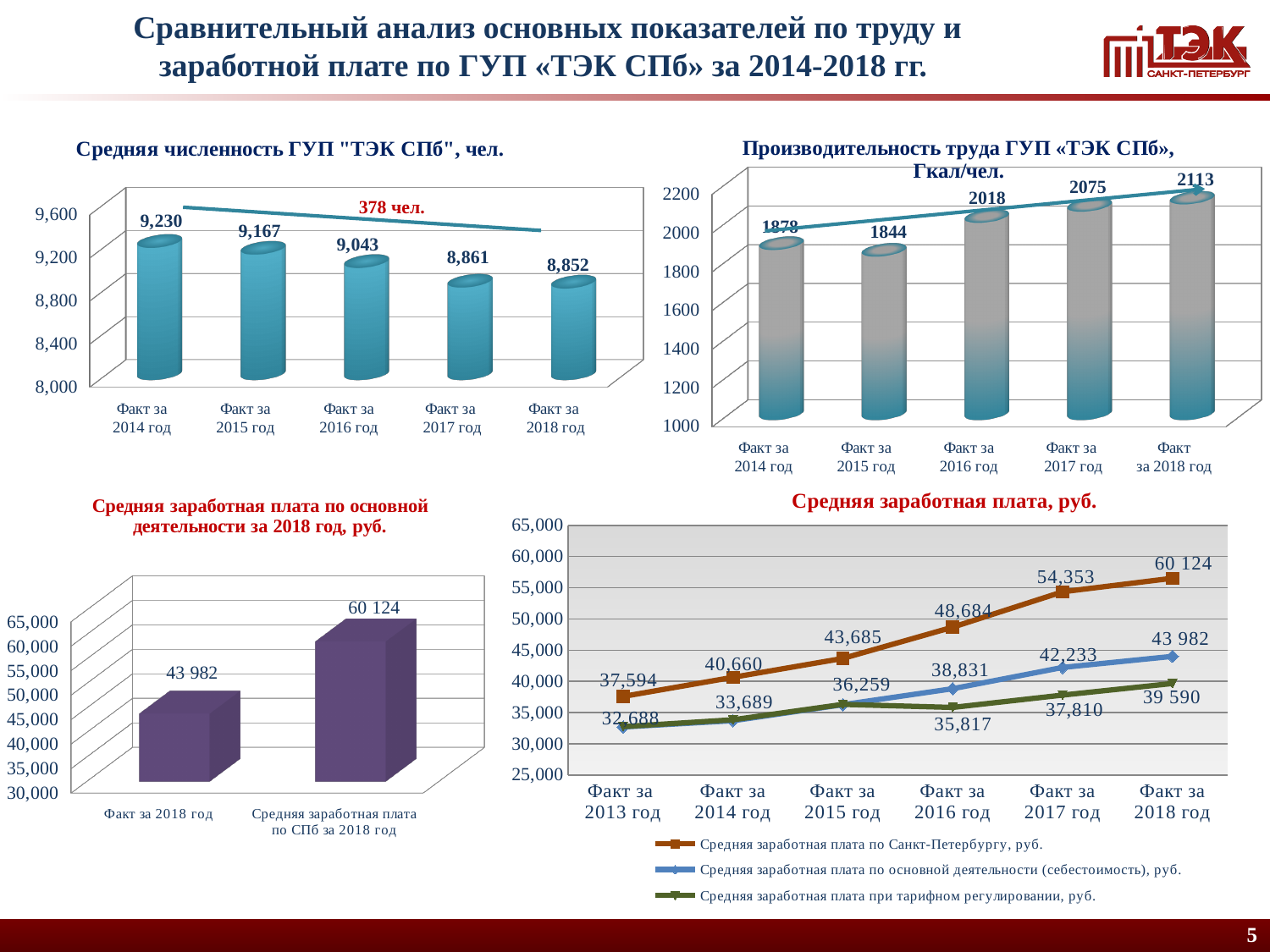
What kind of chart is 'Средняя заработная плата, руб.' at the bottom right of the slide? line chart In the chart 'Средняя численность ГУП "ТЭК СПб", чел.', which year has the lowest value? Факт за 2018 год In the chart 'Производительность труда ГУП «ТЭК СПб», Гкал/чел.', what is the value for Факт за 2016 год? 2018 In the chart 'Средняя численность ГУП "ТЭК СПб", чел.', what is the value for Факт за 2014 год? 9,230 In the chart 'Средняя численность ГУП "ТЭК СПб", чел.', what is the difference between the values for 2014 and 2018? 378 In the chart 'Средняя заработная плата, руб.', what is the value of 'Средняя заработная плата по Санкт-Петербургу, руб.' for Факт за 2017 год? 54,353 In the chart 'Производительность труда ГУП «ТЭК СПб», Гкал/чел.', which is larger: the value for 2014 or the value for 2015? 2014 In the chart 'Производительность труда ГУП «ТЭК СПб», Гкал/чел.', how many bars are plotted? 5 In the chart 'Средняя численность ГУП "ТЭК СПб", чел.', do the values rise or fall from 2014 to 2018? fall In the chart 'Производительность труда ГУП «ТЭК СПб», Гкал/чел.', which year has the highest value? Факт за 2018 год In the chart 'Средняя заработная плата по основной деятельности за 2018 год, руб.', what is the value for Факт за 2018 год? 43 982 In the chart 'Средняя заработная плата, руб.', how many series does the legend list? 3